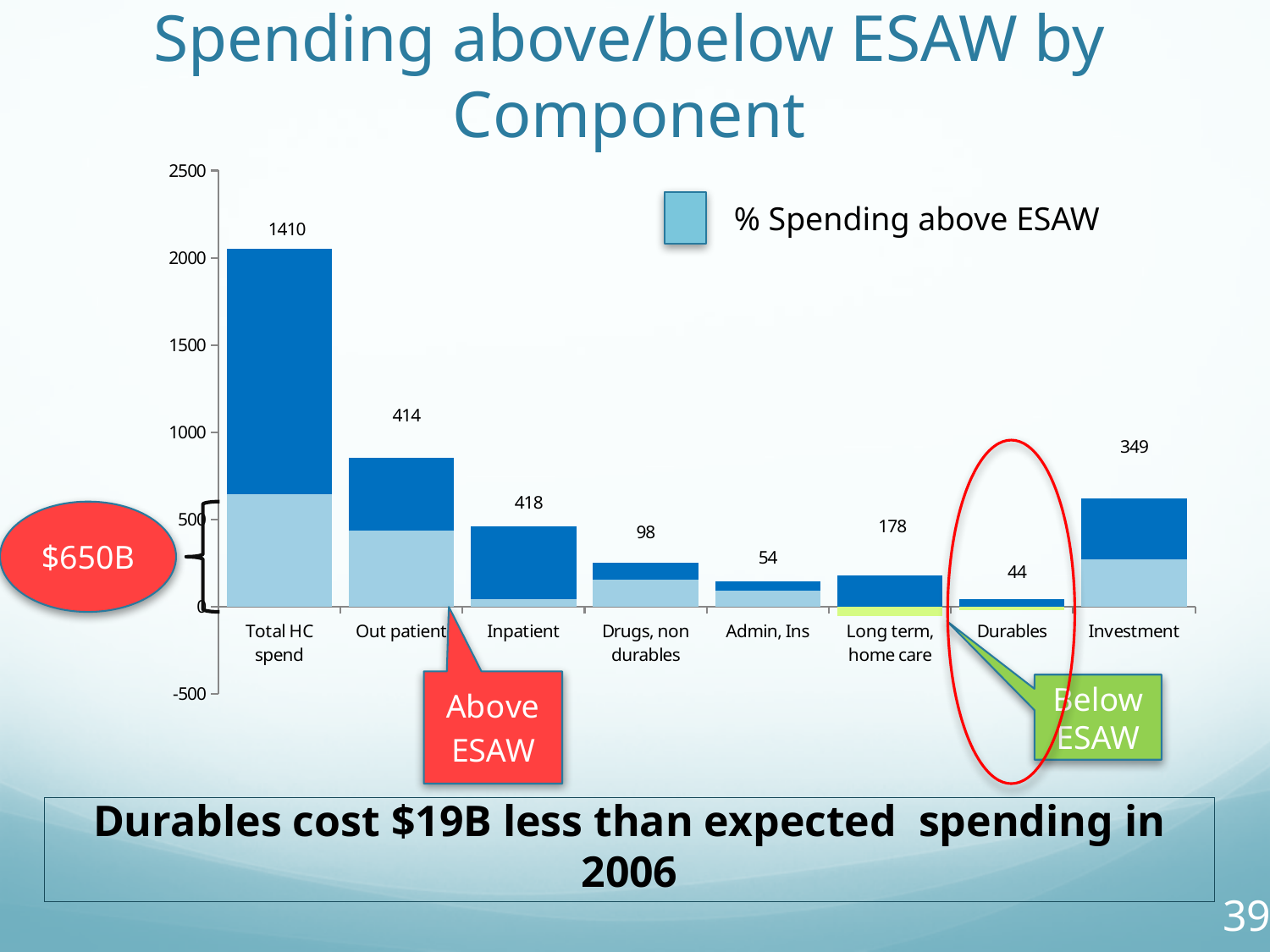
What is the legend entry shown on the chart? % Spending above ESAW Is the top of the stacked bar for Total HC spend greater or less than 2000? greater What is the difference between the data labels for Total HC spend and Out patient? 996 Which category has the lowest data label? Durables What is the data label shown above the bar for Investment? 349 What is the data label shown above the bar for Durables? 44 What kind of chart is shown on the slide? bar chart How many series does the chart's legend list? 1 What is the data label shown above the bar for Total HC spend? 1410 What is the title of the chart? Spending above/below ESAW by Component How many categories are shown on the x axis of the chart? 8 Which category has the highest data label? Total HC spend